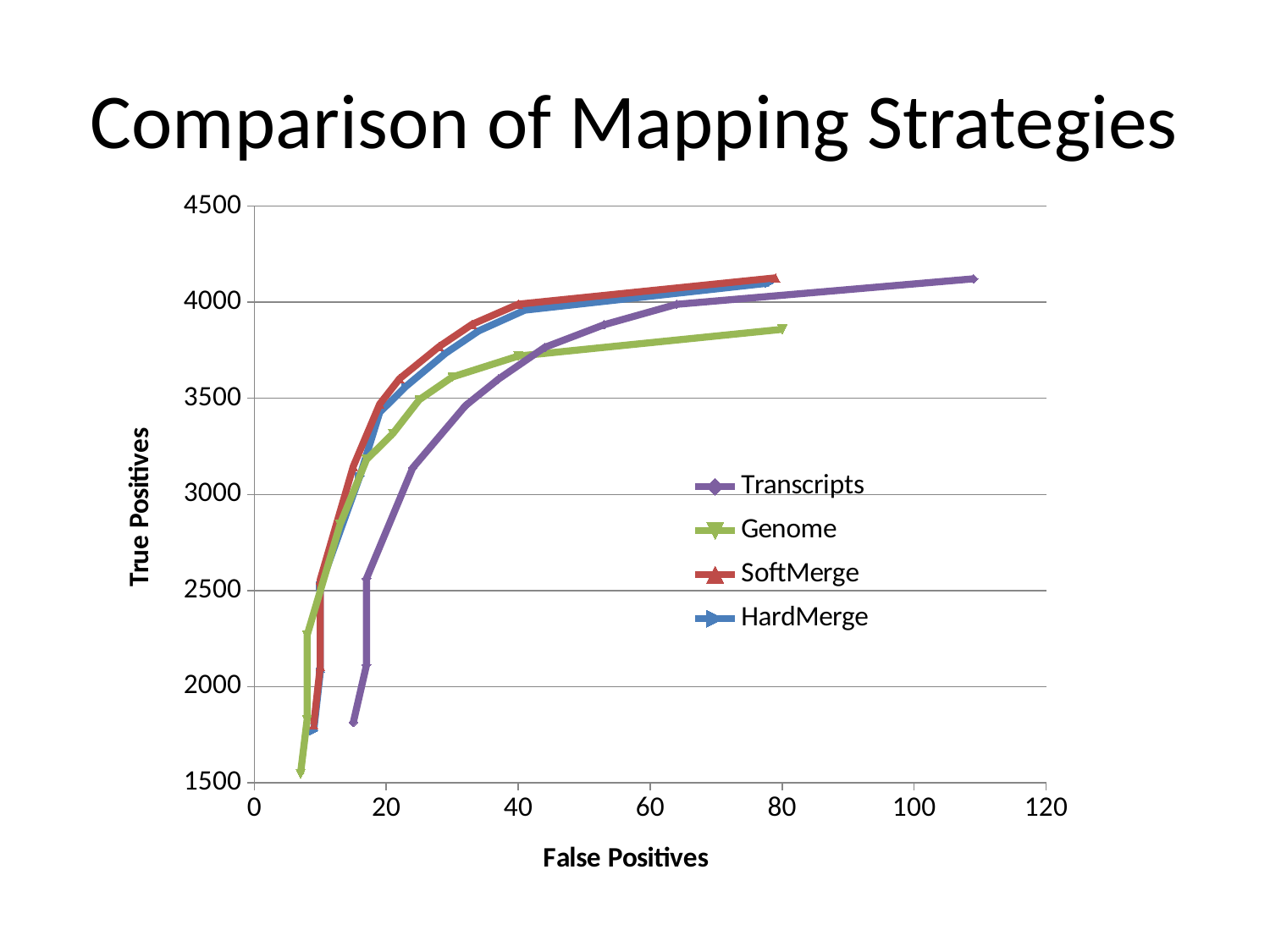
As False Positives increase, do the True Positives values of the series rise or fall? rise Is the largest False Positives value reached by the Transcripts series greater or less than 100? greater What kind of chart is shown on the slide? line chart What is the label of the x axis? False Positives How many series does the legend list? 4 Which series has the lowest True Positives value at its leftmost point? Genome Is the highest True Positives value reached by the HardMerge series greater or less than 4000? greater What is the title of the chart? Comparison of Mapping Strategies Is the lowest True Positives value of the Genome series greater or less than 2000? less Which series extends to the largest False Positives value? Transcripts